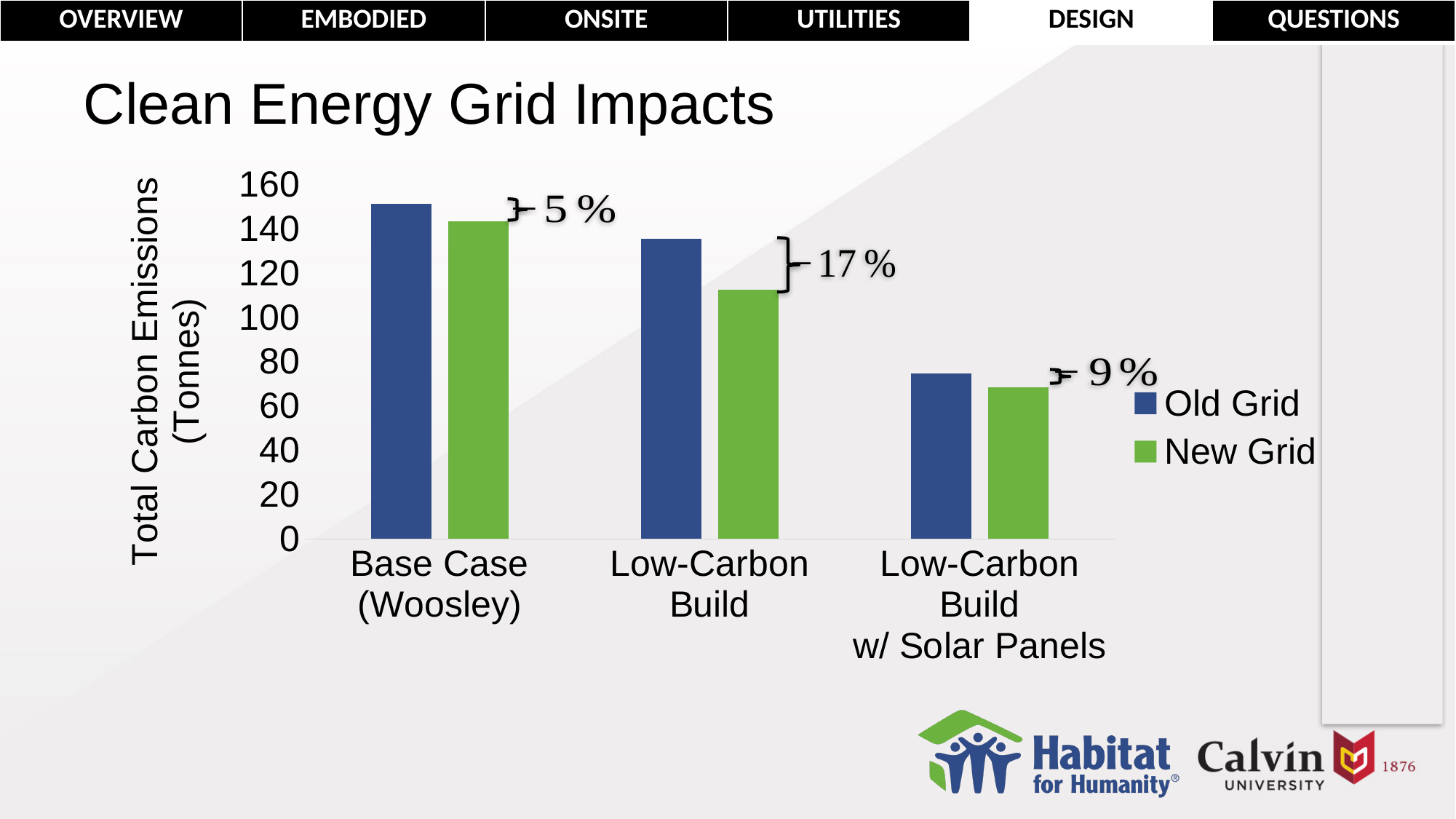
Is the Old Grid value for Base Case (Woosley) greater or less than 140? greater Which category has the highest Old Grid bar? Base Case (Woosley) For Low-Carbon Build, which is larger: the Old Grid value or the New Grid value? Old Grid How many series does the legend list? 2 Is the New Grid value for Low-Carbon Build greater or less than 120? less How many categories are shown on the x axis? 3 Is the Old Grid value for Low-Carbon Build w/ Solar Panels greater or less than 80? less What percentage reduction is annotated between the Old Grid and New Grid bars for Low-Carbon Build? 17% What kind of chart is shown on the slide? bar chart What is the label on the y axis of the chart? Total Carbon Emissions (Tonnes) Do the Old Grid values rise or fall moving from Base Case (Woosley) to Low-Carbon Build w/ Solar Panels? fall Which category has the lowest New Grid bar? Low-Carbon Build w/ Solar Panels